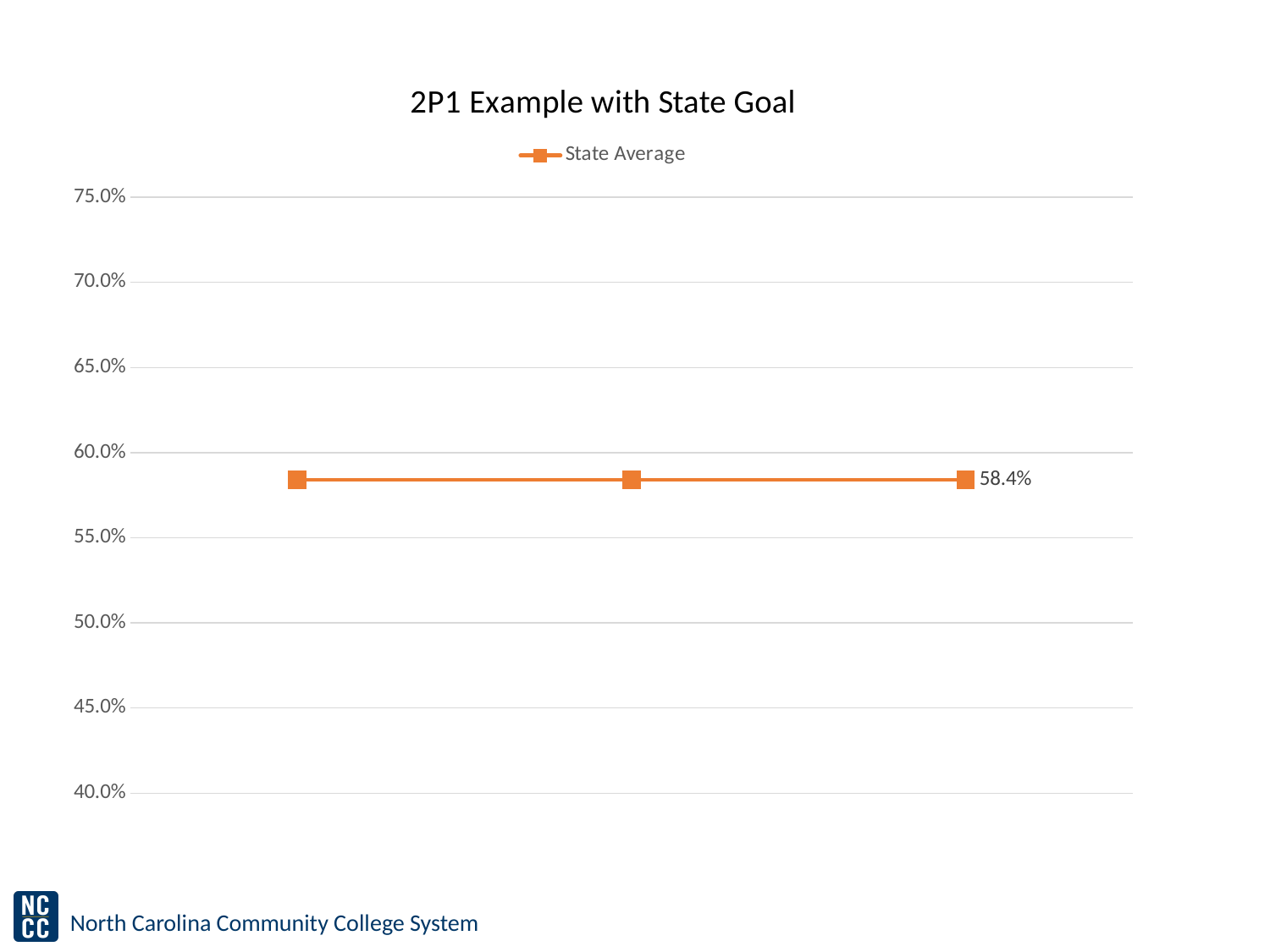
What is the title of the chart? 2P1 Example with State Goal What value is labelled on the rightmost point of the State Average line? 58.4% Does the State Average line rise, fall, or stay flat from left to right? stay flat What series name appears in the legend? State Average How many data points are plotted on the State Average line? 3 Is the value for the State Average line greater or less than 60.0%? less What kind of chart is shown on the slide? line chart Is the value for the State Average line greater or less than 55.0%? greater How many series does the legend list? 1 What is the highest value shown on the vertical axis? 75.0%